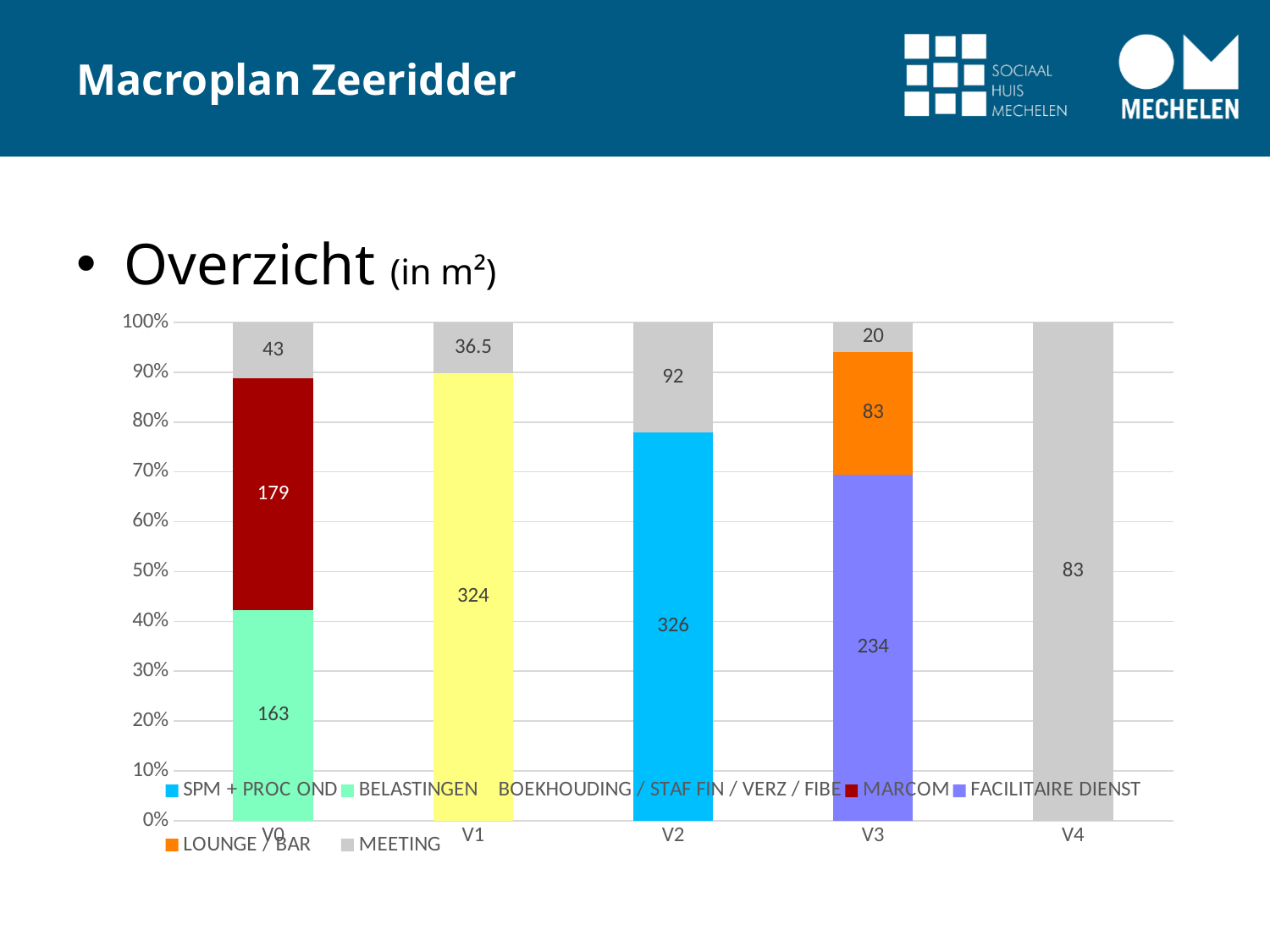
What is the value for FACILITAIRE DIENST in V3? 234 What is the difference between MARCOM and BELASTINGEN in V0? 16 What kind of chart is shown on the slide? Stacked bar chart How many series does the legend list? 7 What is the value for BOEKHOUDING / STAF FIN / VERZ / FIBE in V1? 324 Which category has the lowest MEETING value? V3 What is the value for MEETING in V1? 36.5 Which category has the highest MEETING value? V2 Which is larger: SPM + PROC OND in V2 or BOEKHOUDING / STAF FIN / VERZ / FIBE in V1? SPM + PROC OND in V2 What is the value for MEETING in V0? 43 How many categories are shown on the x axis? 5 What is the total of the stacked bar for V3? 337